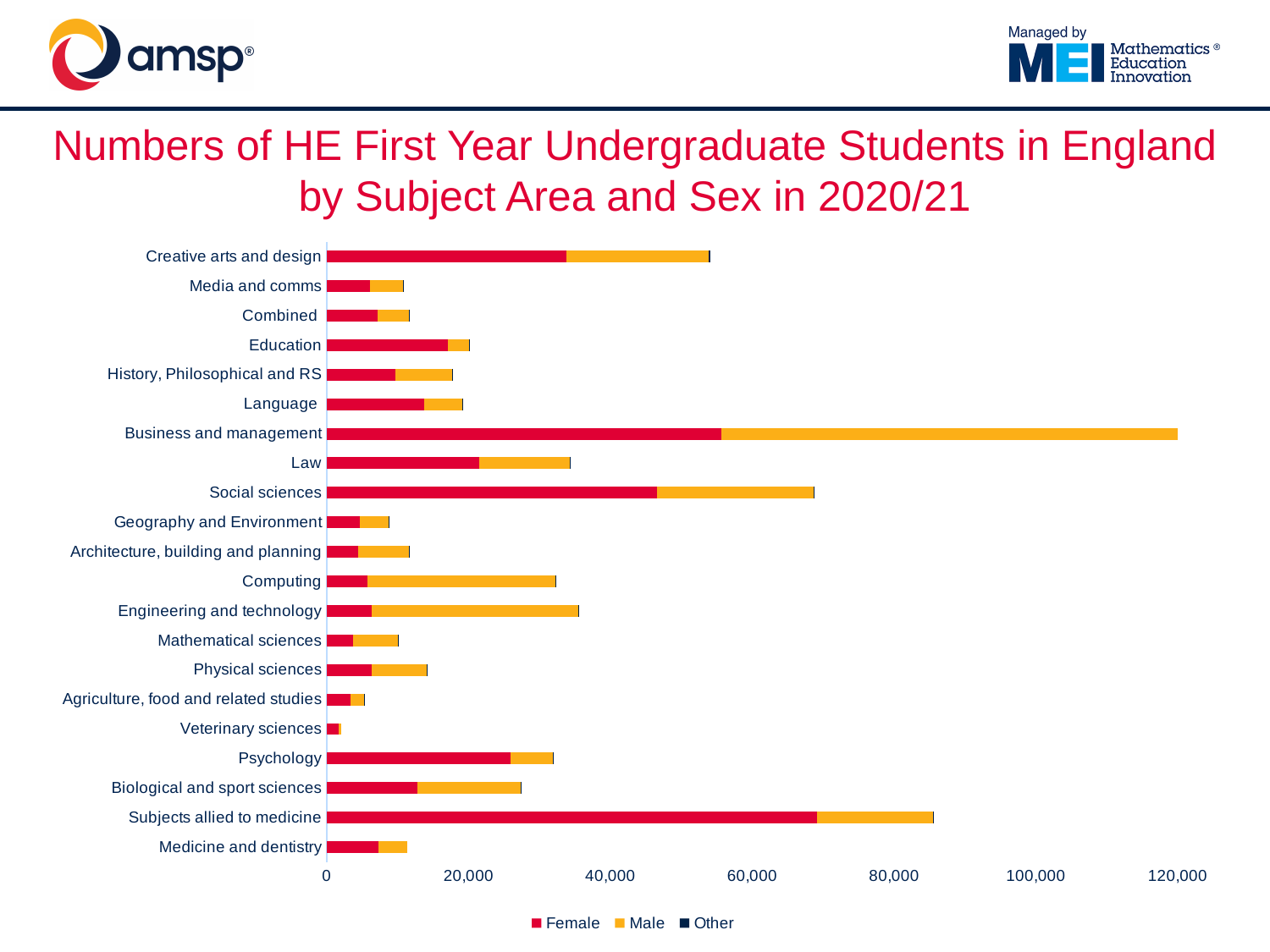
How many series does the legend list? 3 Which subject area has the lowest total number of first year undergraduate students? Veterinary sciences Is the total value for Creative arts and design greater or less than 40,000? greater Is the total value for Subjects allied to medicine greater or less than 80,000? greater Which subject area has the highest total number of first year undergraduate students? Business and management What colour represents the Male series in the chart? Orange Which subject area has the largest Female segment? Subjects allied to medicine Is the total value for Veterinary sciences greater or less than 20,000? less What kind of chart is shown on the slide? Stacked bar chart How many subject areas are shown on the chart? 21 Which has a larger total bar, Subjects allied to medicine or Social sciences? Subjects allied to medicine